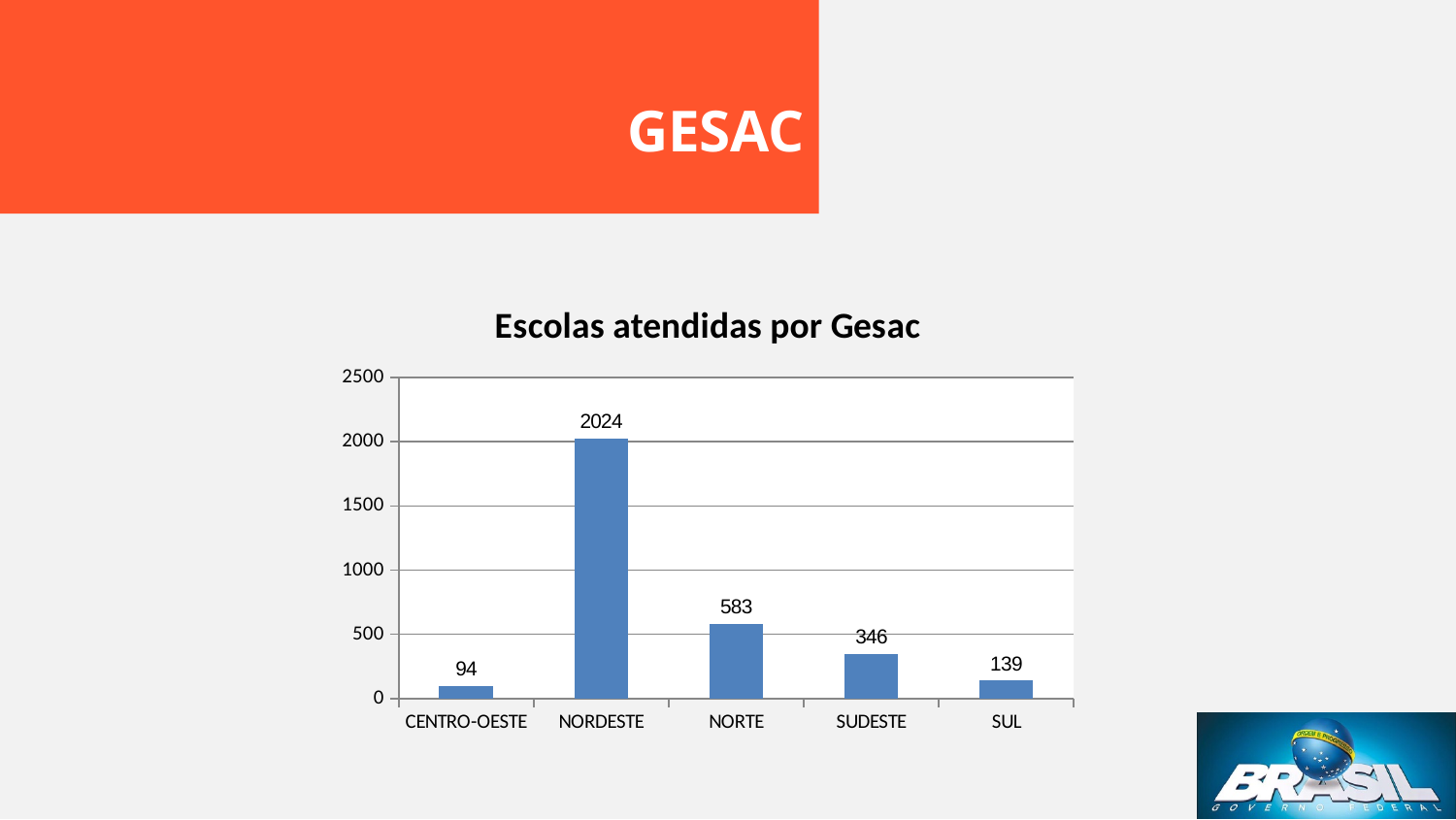
Which is larger, the value for SUL or the value for CENTRO-OESTE? SUL How many regions are shown on the x axis? 5 Is the value for NORTE greater or less than 500? greater What is the value for SUL? 139 Which region has the lowest number of schools served? CENTRO-OESTE What is the value for CENTRO-OESTE? 94 What kind of chart is shown? bar chart What is the difference between the values for NORTE and SUDESTE? 237 What is the title of the chart? Escolas atendidas por Gesac Which region has the highest number of schools served? NORDESTE What is the value for NORDESTE? 2024 What is the difference between the values for NORDESTE and NORTE? 1441